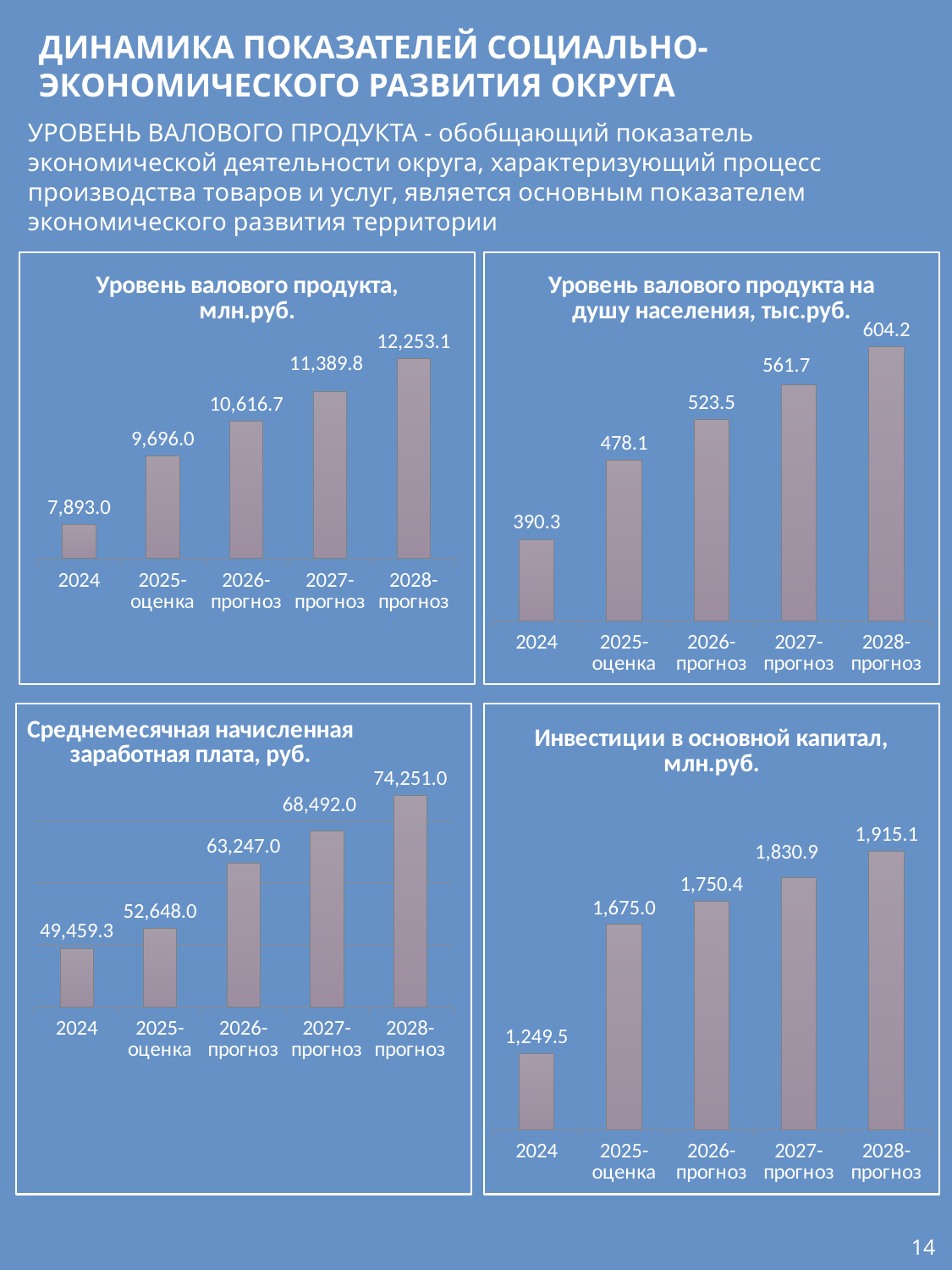
In the chart 'Инвестиции в основной капитал, млн.руб.', which category has the highest value? 2028-прогноз What kind of chart is 'Среднемесячная начисленная заработная плата, руб.'? bar chart In the chart 'Уровень валового продукта на душу населения, тыс.руб.', which category has the lowest value? 2024 In the chart 'Среднемесячная начисленная заработная плата, руб.', what is the value for 2025-оценка? 52,648.0 In the chart 'Уровень валового продукта, млн.руб.', what is the value for 2028-прогноз? 12,253.1 In the chart 'Уровень валового продукта на душу населения, тыс.руб.', what is the value for 2026-прогноз? 523.5 How many categories are shown in the chart 'Уровень валового продукта на душу населения, тыс.руб.'? 5 In the chart 'Инвестиции в основной капитал, млн.руб.', what is the difference between the 2026-прогноз value and the 2025-оценка value? 75.4 In the chart 'Инвестиции в основной капитал, млн.руб.', what is the value for 2027-прогноз? 1,830.9 In the chart 'Среднемесячная начисленная заработная плата, руб.', what is the difference between the 2028-прогноз value and the 2024 value? 24,791.7 In the chart 'Уровень валового продукта, млн.руб.', do the values rise or fall from 2024 to 2028-прогноз? rise In the chart 'Уровень валового продукта, млн.руб.', what is the value for 2024? 7,893.0